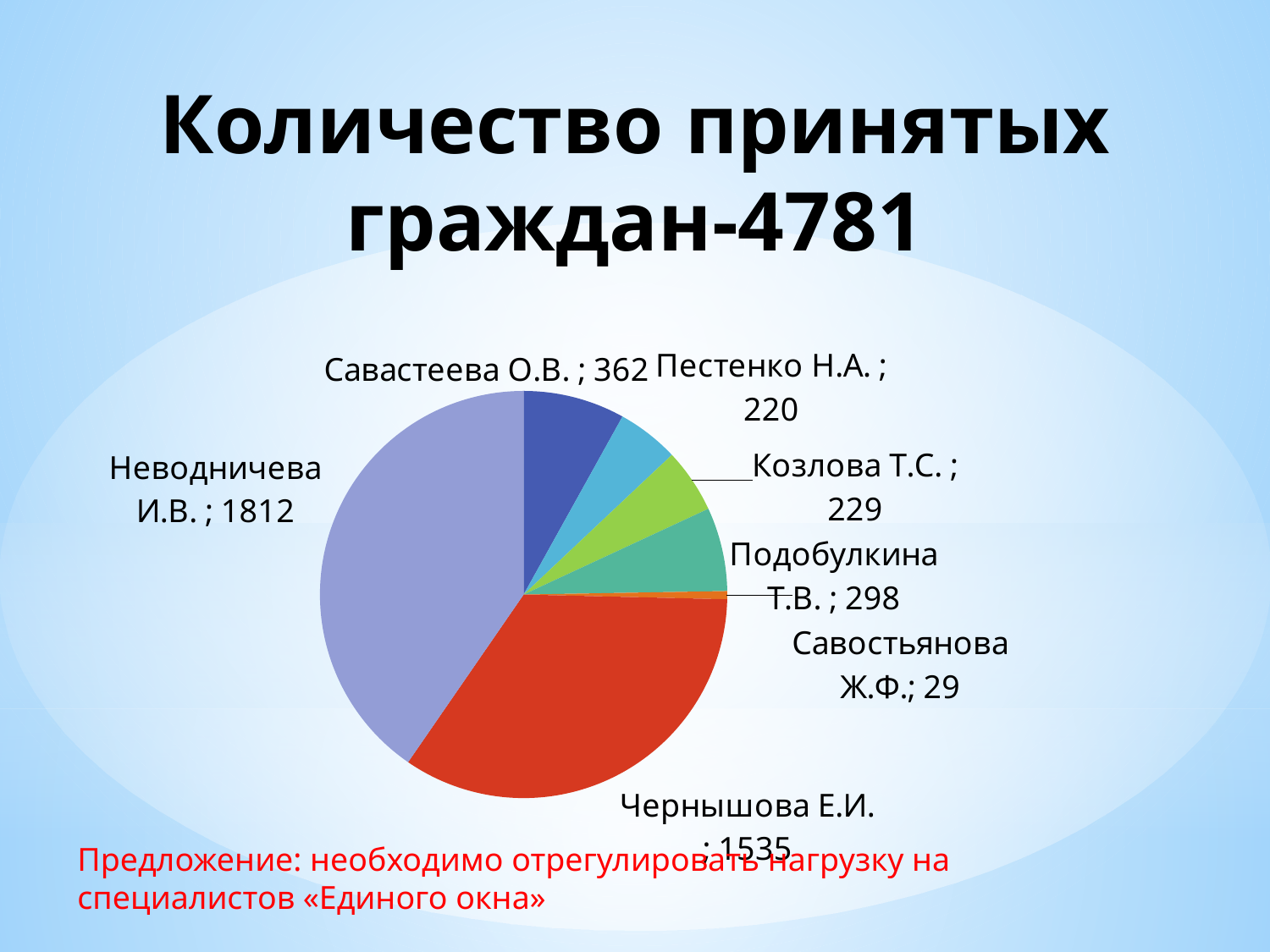
Which is larger, the value for Козлова Т.С. or the value for Подобулкина Т.В.? Подобулкина Т.В. What is the difference between the values for Савастеева О.В. and Пестенко Н.А.? 142 How many citizens were received by Неводничева И.В.? 1812 Which specialist has the smallest slice of the pie? Савостьянова Ж.Ф. What type of chart is shown on the slide? pie chart What is the value for Савостьянова Ж.Ф.? 29 Which specialist has the largest slice of the pie? Неводничева И.В. What is the value for Чернышова Е.И.? 1535 What is the difference between the values for Неводничева И.В. and Чернышова Е.И.? 277 How many slices does the pie chart have? 7 What is the value for Подобулкина Т.В.? 298 What is the title of the slide? Количество принятых граждан-4781